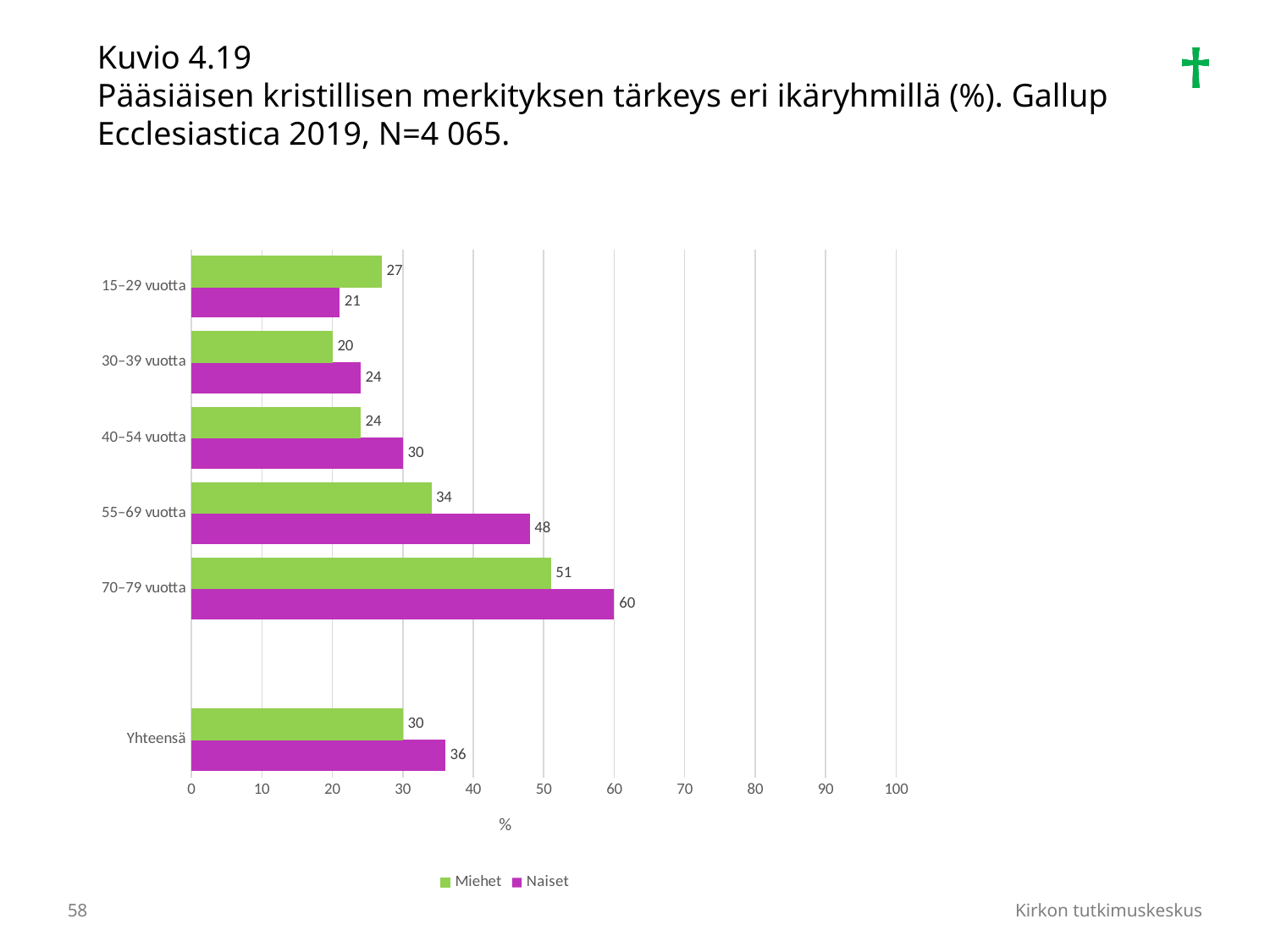
How many categories are shown on the vertical axis? 6 Which age group has the lowest value for Naiset? 15–29 vuotta Which colour represents Naiset in the chart? Purple How many series does the legend list? 2 What is the value for Naiset in the 70–79 vuotta age group? 60 What is the value for Naiset in the Yhteensä category? 36 What kind of chart is shown on the slide? Bar chart In the 15–29 vuotta age group, which is larger, Miehet or Naiset? Miehet What is the difference between Naiset and Miehet in the 55–69 vuotta age group? 14 What is the value for Miehet in the 30–39 vuotta age group? 20 Which age group has the highest value for Miehet? 70–79 vuotta What is the value for Miehet in the 15–29 vuotta age group? 27